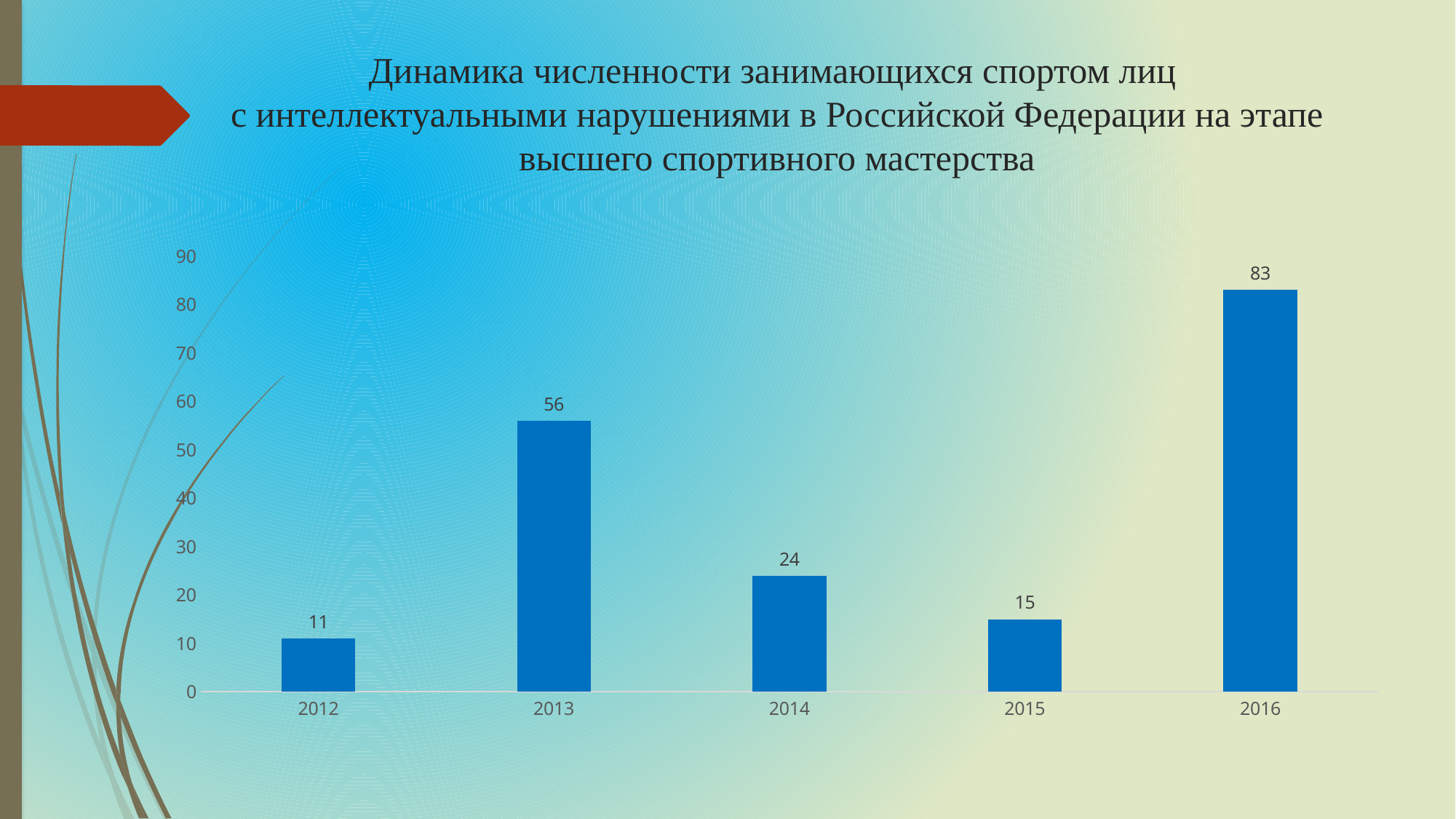
Which year has the highest value? 2016 Which year has the lowest value? 2012 What is the value for 2013? 56 What is the difference between the values for 2016 and 2013? 27 How many years are shown on the x axis? 5 What is the difference between the values for 2014 and 2015? 9 What is the value for 2016? 83 Is the value for 2013 greater or less than 50? greater What kind of chart is shown on the slide? bar chart Which is larger, the value for 2014 or the value for 2015? 2014 Do the values rise or fall from 2013 to 2015? fall What is the value for 2012? 11